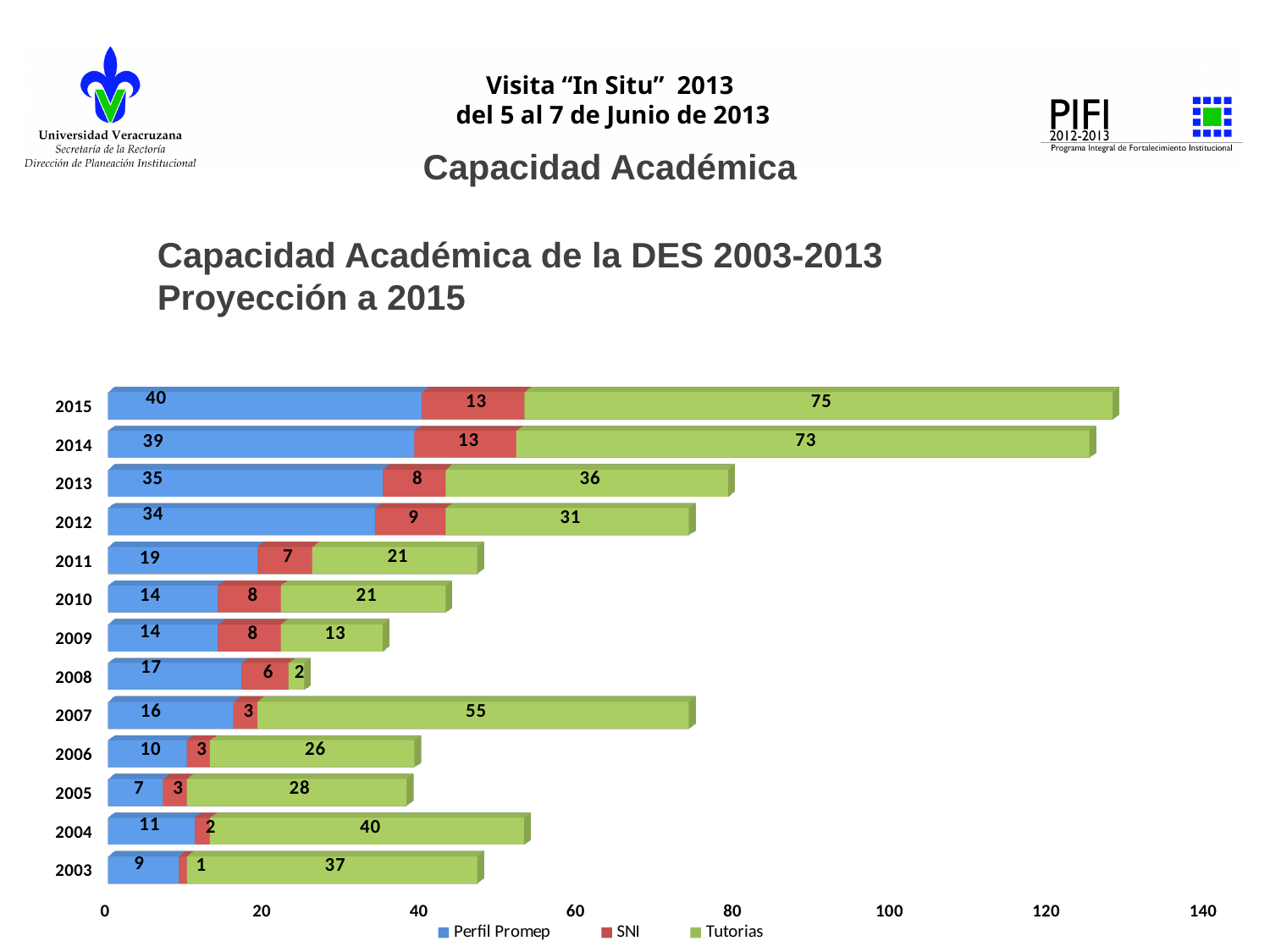
What is the Perfil Promep value for 2007? 16 Which is larger, the Tutorias value for 2007 or the Tutorias value for 2013? 2007 Which year has the highest Tutorias value? 2015 What is the total of the stacked bar for 2014? 125 How many years are shown on the chart? 13 What is the difference between the Perfil Promep values for 2015 and 2013? 5 What is the SNI value for 2012? 9 How many series does the legend list? 3 What is the total of the stacked bar for 2008? 25 What is the Tutorias value for 2015? 75 Which year has the lowest SNI value? 2003 What kind of chart is shown on the slide? Stacked bar chart